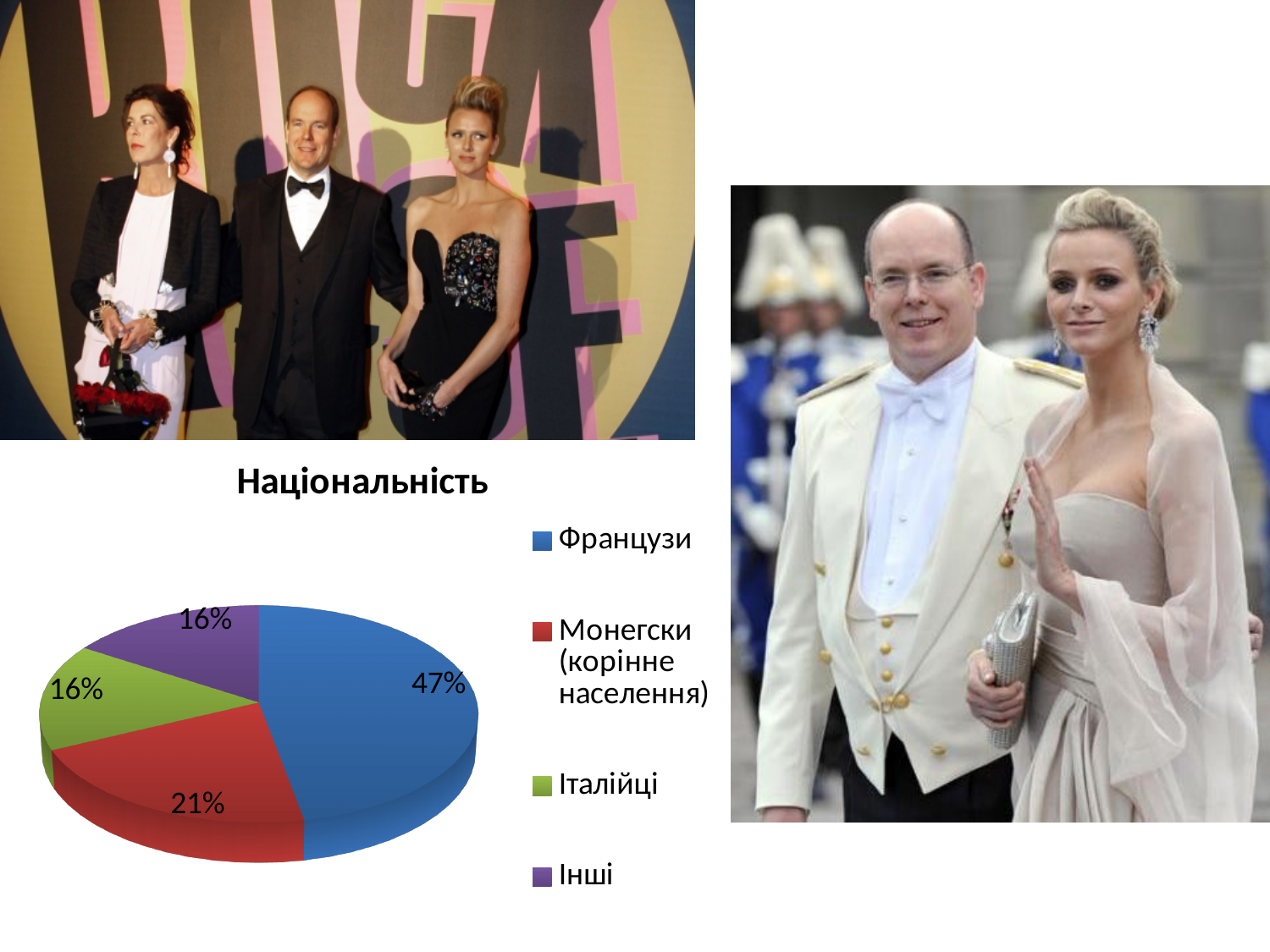
What share of the pie is labelled Італійці? 16% What share of the pie is labelled Інші? 16% What colour is the slice for Французи? blue How many slices does the pie chart have? 4 What is the difference between the shares for Французи and Монегски (корінне населення)? 26% What share of the pie is labelled Монегски (корінне населення)? 21% What is the title of the chart? Національність Which is larger, the share for Монегски (корінне населення) or the share for Італійці? Монегски (корінне населення) What kind of chart is shown on the slide? pie chart Which category has the largest slice of the pie? Французи How many entries does the legend list? 4 What share of the pie is labelled Французи? 47%